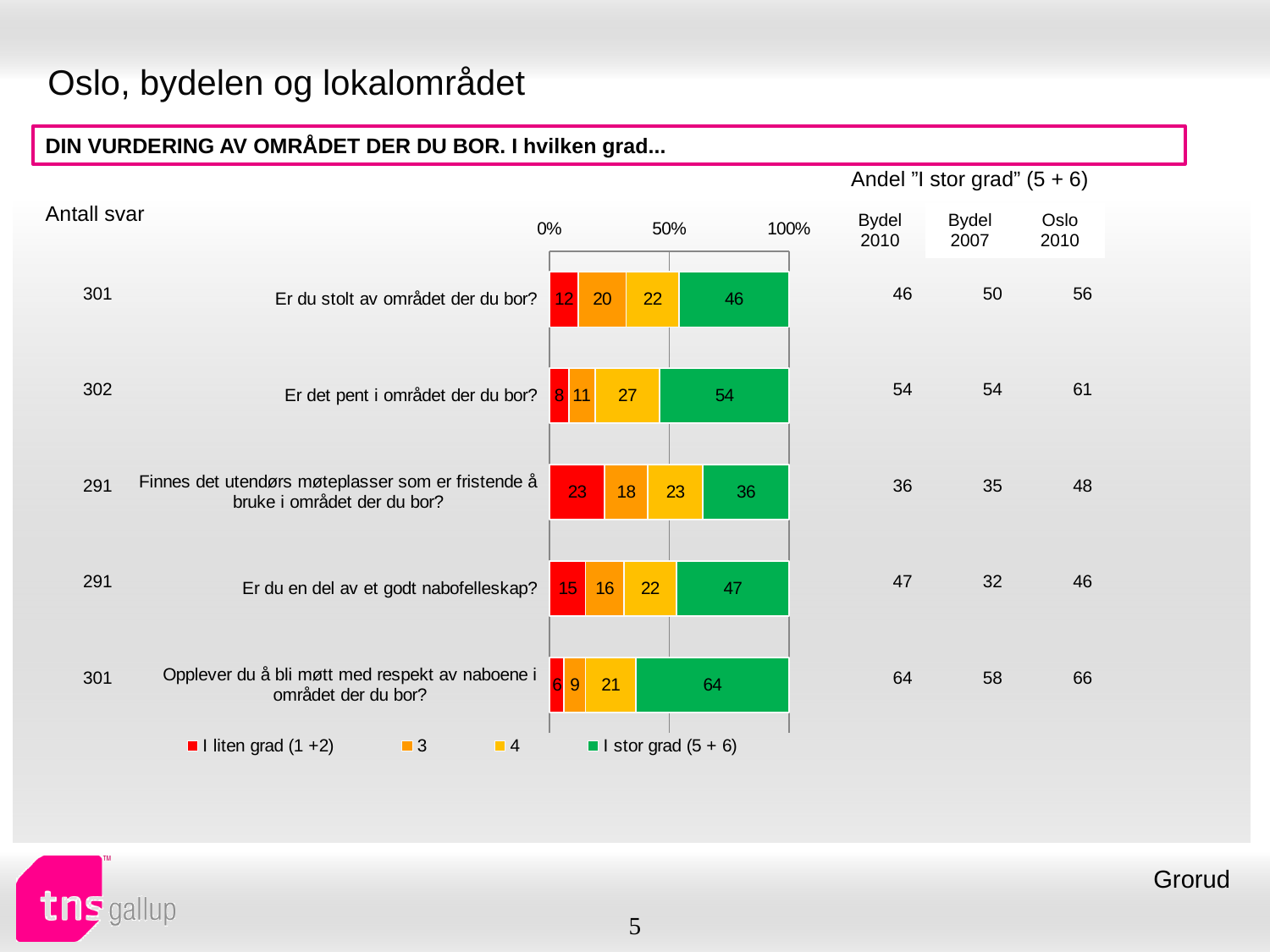
Which question has the highest "I stor grad (5 + 6)" value? Opplever du å bli møtt med respekt av naboene i området der du bor? What is the difference between the "I stor grad (5 + 6)" values for "Opplever du å bli møtt med respekt av naboene i området der du bor?" and "Er du stolt av området der du bor?"? 18 What kind of chart is shown on the slide? Stacked bar chart What is the value of the "I stor grad (5 + 6)" segment for "Er det pent i området der du bor?"? 54 What is the value of the "4" segment for "Er det pent i området der du bor?"? 27 What is the first entry in the chart legend? I liten grad (1 +2) How many series does the chart legend list? 4 What is the total of the stacked bar for "Er du stolt av området der du bor?"? 100 What is the value of the "I liten grad (1 +2)" segment for "Finnes det utendørs møteplasser som er fristende å bruke i området der du bor?"? 23 How many questions (categories) are shown in the bar chart? 5 Which has the larger "I liten grad (1 +2)" value: "Er du stolt av området der du bor?" or "Er du en del av et godt nabofelleskap?"? Er du en del av et godt nabofelleskap? Which question has the lowest "I stor grad (5 + 6)" value? Finnes det utendørs møteplasser som er fristende å bruke i området der du bor?